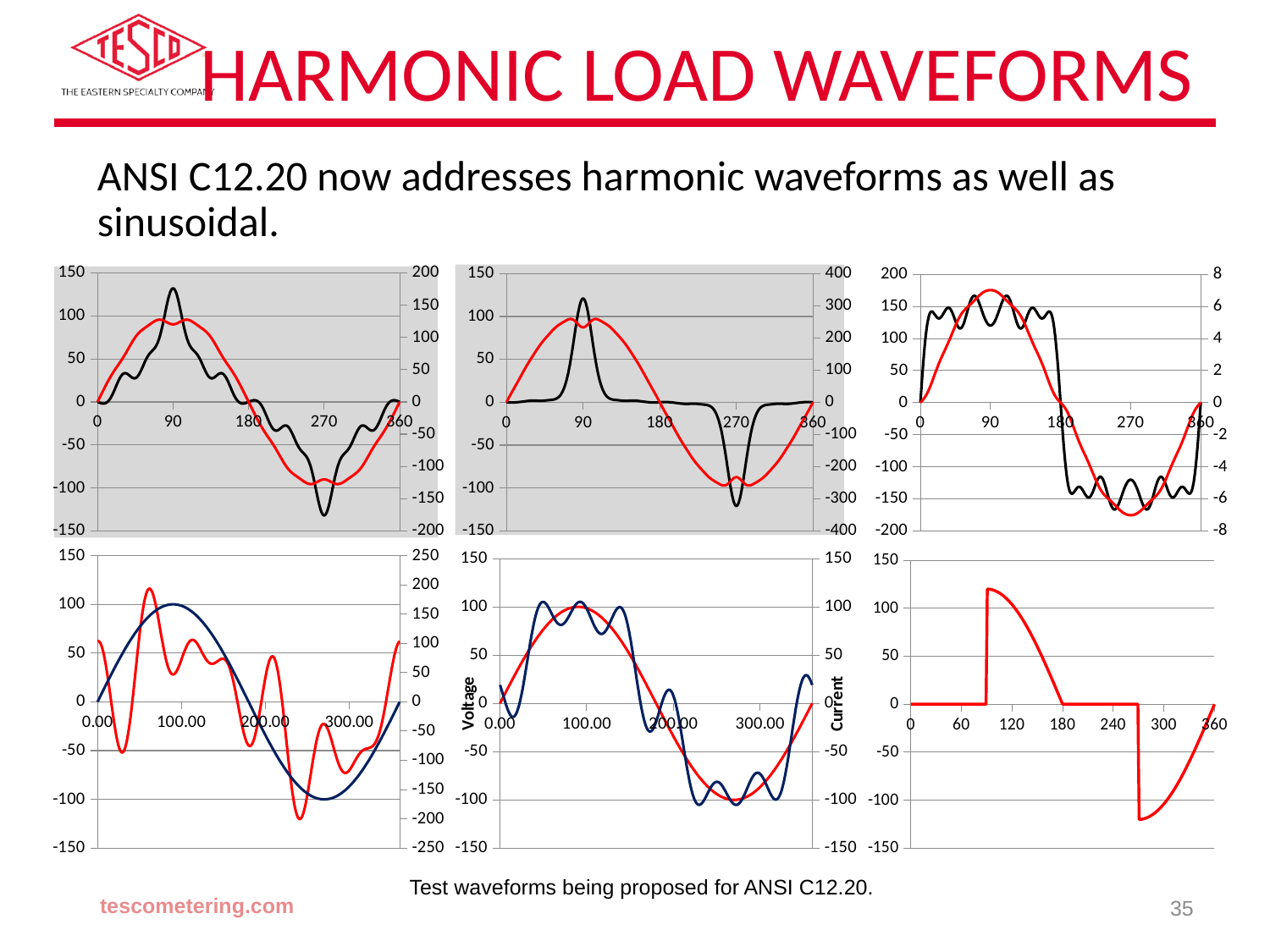
What kind of chart is the top-left chart on the slide? line chart In the top-middle chart, what is the value of the red line at x = 180 on the left axis? 0 In the bottom-right chart, does the red line rise or fall between x = 120 and x = 180? fall In the bottom-middle chart, what is the label on the right vertical axis? Current In the bottom-right chart, is the lowest value of the red line greater or less than -100? less In the bottom-right chart, does the red line rise or fall between x = 300 and x = 360? rise In the bottom-right chart, what is the value of the red line at x = 0? 0 In the bottom-right chart, is the peak value of the red line greater or less than 100? greater In the bottom-right chart, what is the value of the red line at x = 240? 0 In the bottom-middle chart, what is the label on the left vertical axis? Voltage How many charts are shown on the slide? 6 In the top-left chart, what is the value of the red line at x = 0 on the left axis? 0